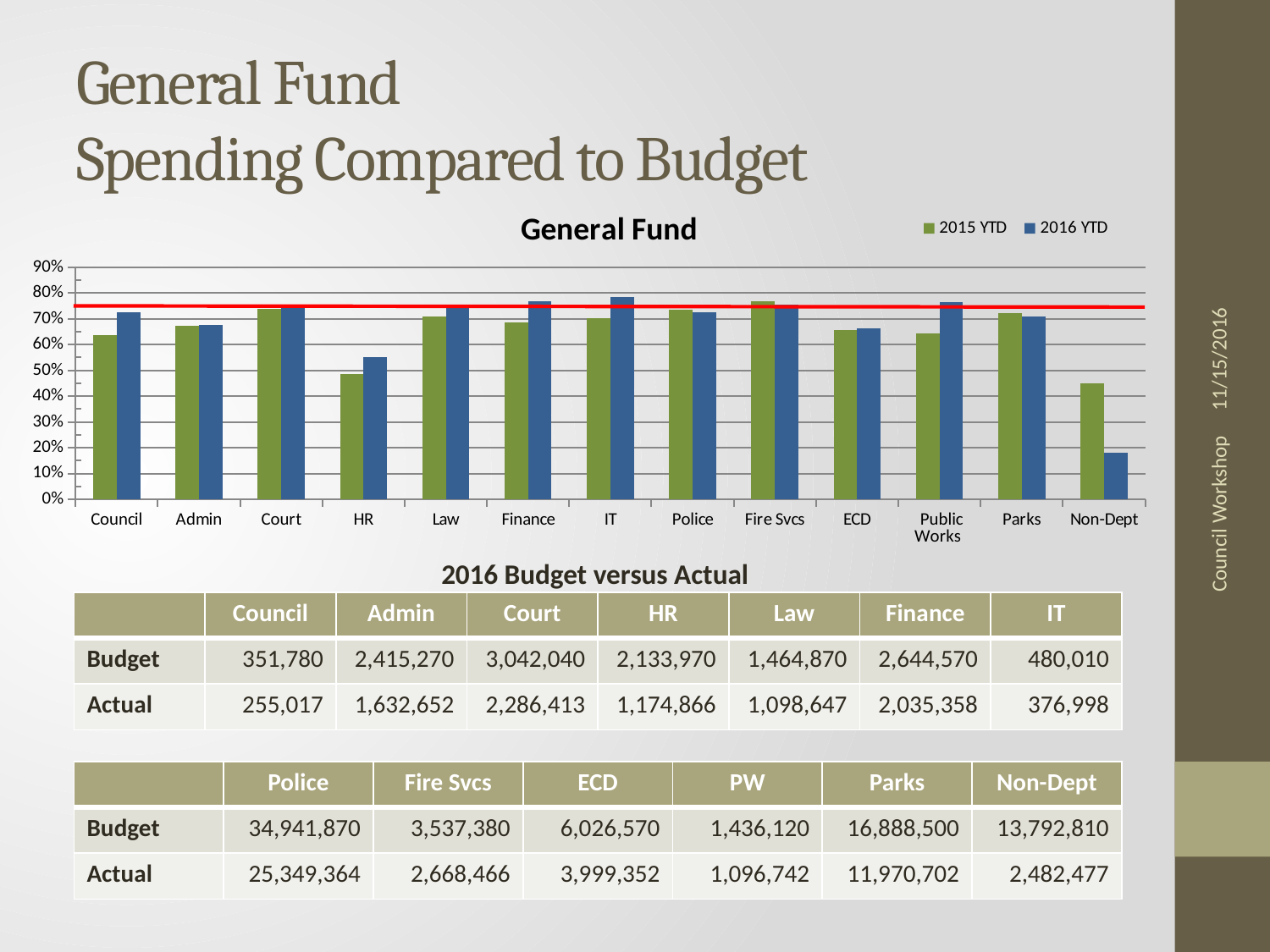
For HR, which is larger: the 2015 YTD value or the 2016 YTD value? 2016 YTD What kind of chart is shown on the slide? bar chart Is the 2015 YTD value for Council greater or less than 60%? greater Which department has the lowest 2016 YTD value in the chart? Non-Dept Is the 2016 YTD value for Non-Dept greater or less than 20%? less For Non-Dept, which is larger: the 2015 YTD value or the 2016 YTD value? 2015 YTD Which department has the lowest 2015 YTD value in the chart? Non-Dept Which department has the highest 2015 YTD value in the chart? Fire Svcs Is the 2016 YTD value for HR greater or less than 50%? greater What is the title of the chart? General Fund How many departments (categories) are shown on the x axis of the chart? 13 How many series does the chart legend list? 2